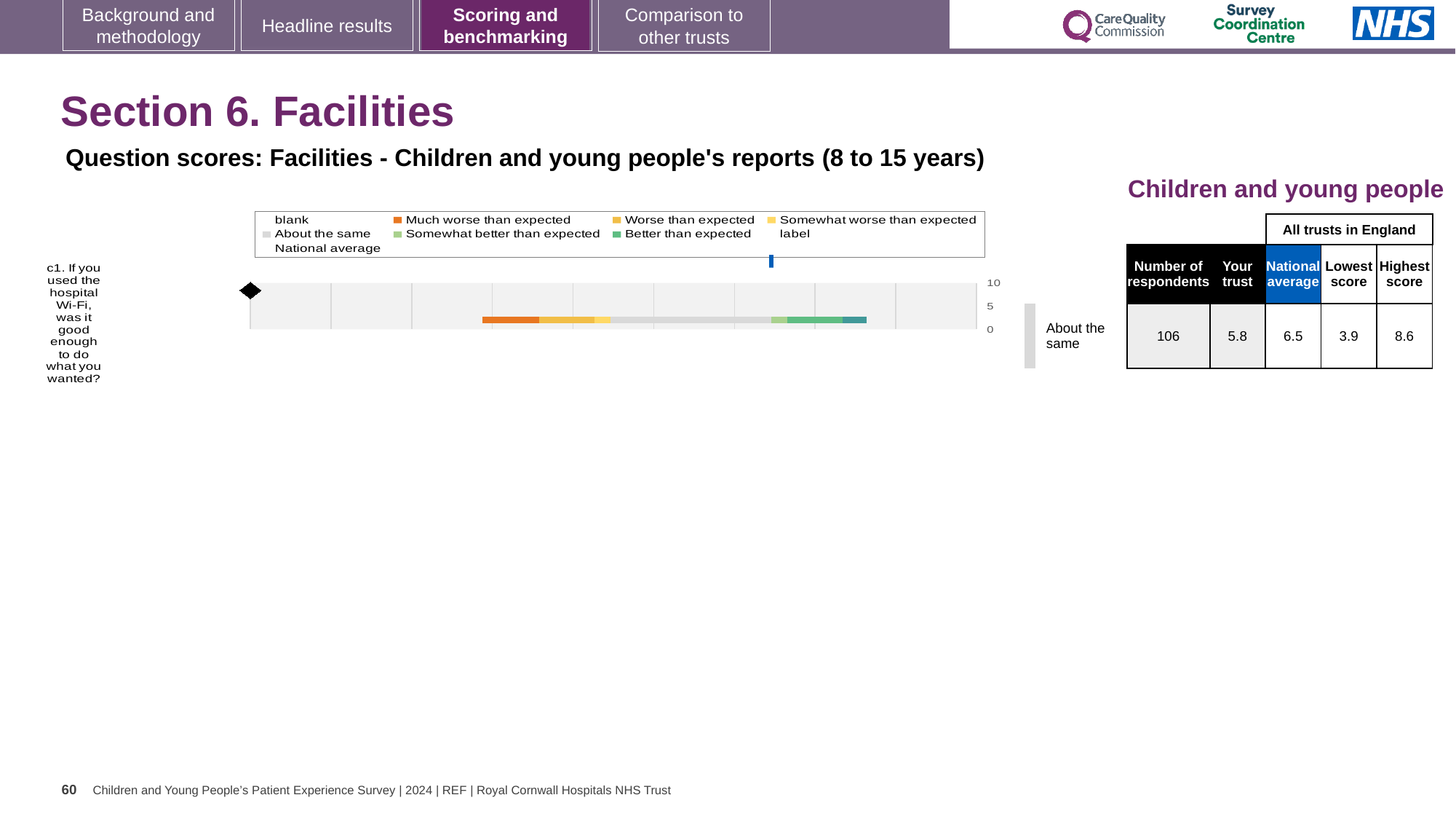
What is the 'Your trust' score for question c1 about hospital Wi-Fi? 5.8 What is the national average score for question c1 about hospital Wi-Fi? 6.5 What benchmark category is given for question c1 about hospital Wi-Fi? About the same Which is larger for question c1: the 'Your trust' score or the national average? National average What is the lowest score among all trusts in England for question c1? 3.9 What kind of chart is shown for question c1 on the slide? bar chart What colour does the legend use for 'Much worse than expected'? orange What is the difference between the highest score and the lowest score for question c1? 4.7 How many respondents answered question c1 about hospital Wi-Fi? 106 How many questions (categories) are plotted in the chart? 1 What is the highest score among all trusts in England for question c1? 8.6 What colour does the legend use for 'Better than expected'? green